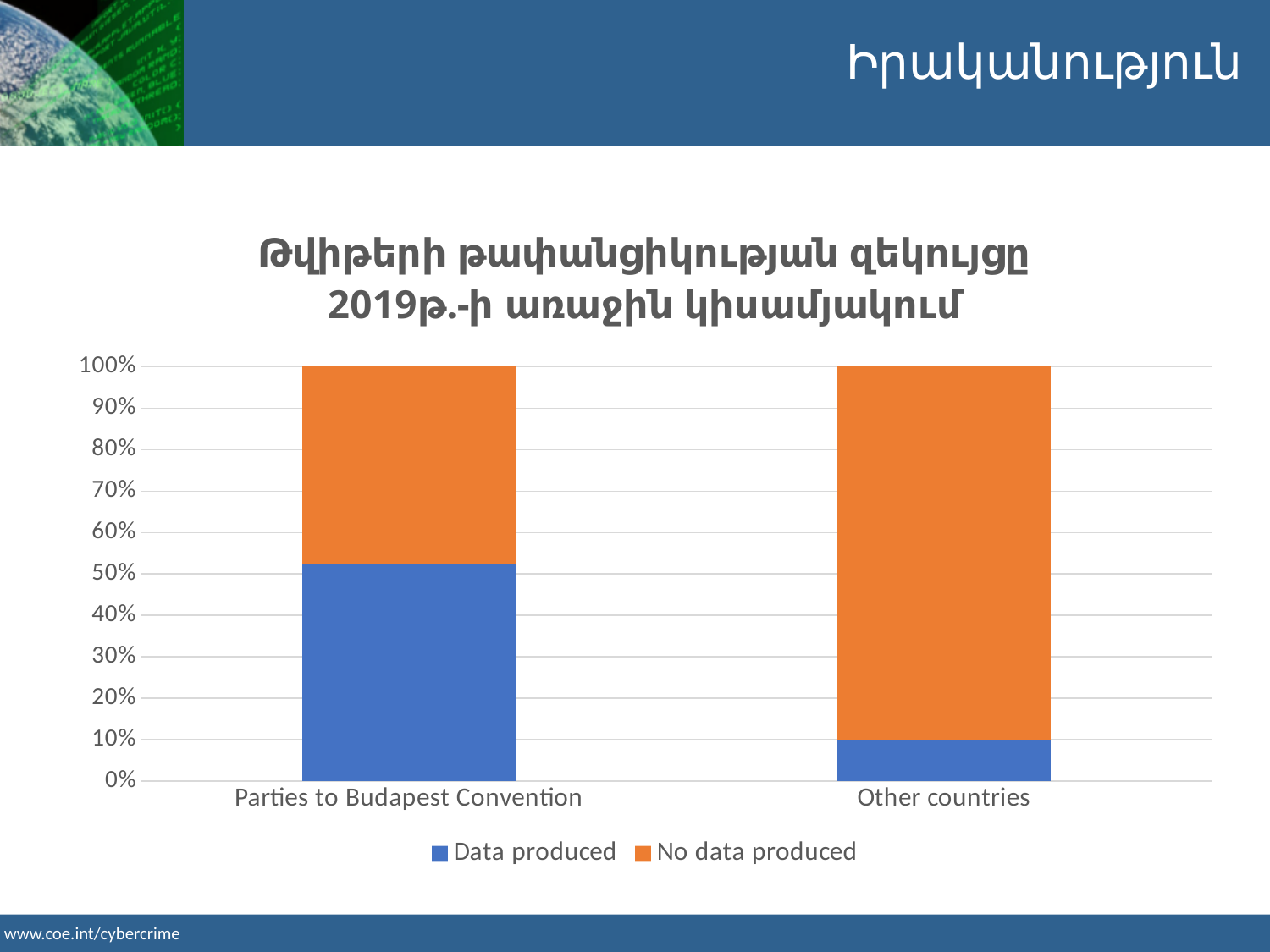
How many categories are shown on the x axis of the chart? 2 What are the two series listed in the chart legend? Data produced, No data produced Is the 'Data produced' value for Other countries greater or less than 20%? less What kind of chart is shown on the slide? bar chart Which category has the larger 'Data produced' share: Parties to Budapest Convention or Other countries? Parties to Budapest Convention Is the 'Data produced' value for Parties to Budapest Convention greater or less than 40%? greater How many series does the chart legend list? 2 Is the 'No data produced' value for Parties to Budapest Convention greater or less than 60%? less Which colour represents the 'Data produced' series in the chart? blue Which category has the lowest 'Data produced' share? Other countries What is the total height of the stacked bar for Other countries? 100%